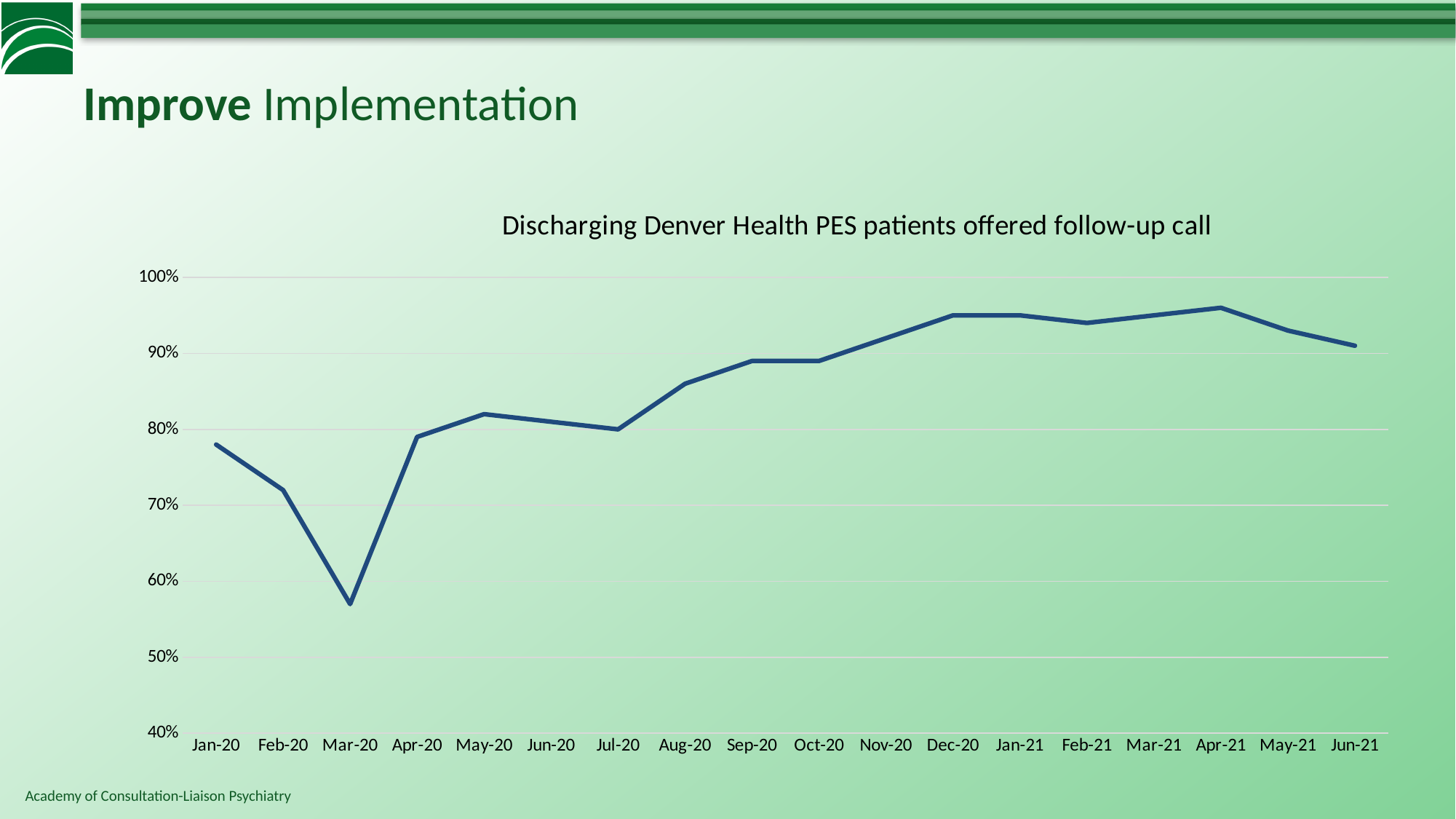
Which is larger, the value for Jan-20 or the value for Mar-20? Jan-20 Which is larger, the value for Dec-20 or the value for Jun-21? Dec-20 Do the values rise or fall from Mar-20 to Dec-20? rise Which month has the lowest value? Mar-20 Is the value for Aug-20 greater or less than 80%? greater Is the value for Mar-20 greater or less than 60%? less How many months are plotted on the x axis? 18 What kind of chart is shown on the slide? line chart Is the value for Jan-20 greater or less than 80%? less What is the title of the chart? Discharging Denver Health PES patients offered follow-up call